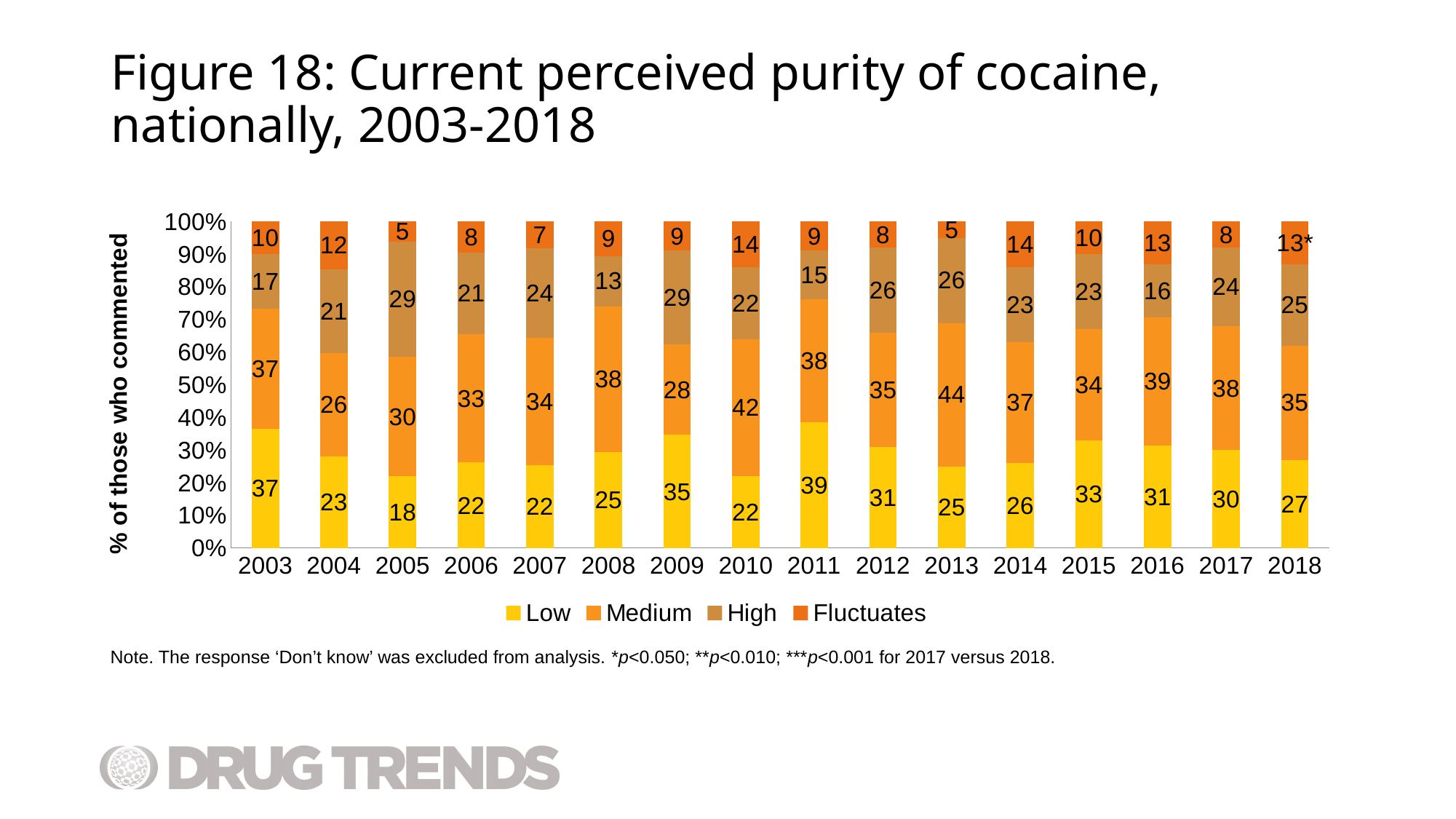
How many years are shown on the x axis? 16 Which is larger, the High value for 2008 or the High value for 2009? 2009 What kind of chart is shown? Stacked bar chart Which year has the lowest value for Low? 2005 What is the difference between the Medium values for 2010 and 2004? 16 How many series does the legend list? 4 What is the value for Fluctuates in 2018? 13 Which year has the highest value for Low? 2011 What is the value for High in 2005? 29 What is the value for Low in 2003? 37 What is the value for Medium in 2013? 44 What is the label of the y axis? % of those who commented